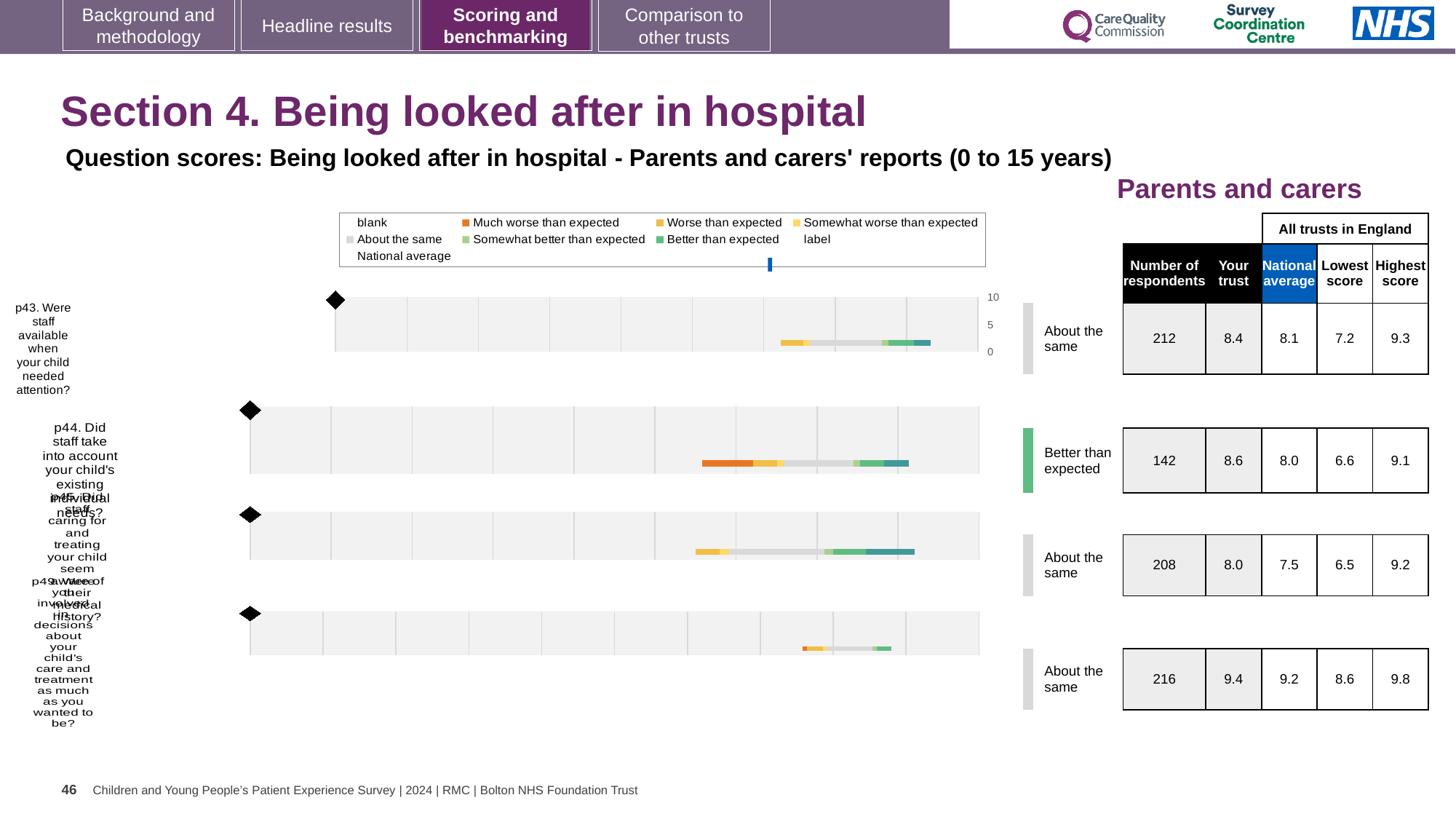
What is the 'Your trust' score for p44 (Did staff take into account your child's existing individual needs?)? 8.6 How many legend entries contain the word 'expected'? 5 How many questions (p43, p44, p45, p49) are plotted on this slide? 4 What is the difference between the 'Your trust' score and the national average for p43? 0.3 What type of chart is used to show the question scores on this slide? bar chart Which question has the lowest 'Your trust' score? p45 What is the national average score for p49 (Were you involved in decisions about your child's care and treatment as much as you wanted to be?)? 9.2 Which question has the highest 'Your trust' score? p49 Which question is rated 'Better than expected'? p44 What is the highest score across all trusts in England for p45? 9.2 For p44, which is larger: the 'Your trust' score or the national average? Your trust What is the number of respondents for p43 (Were staff available when your child needed attention?)? 212